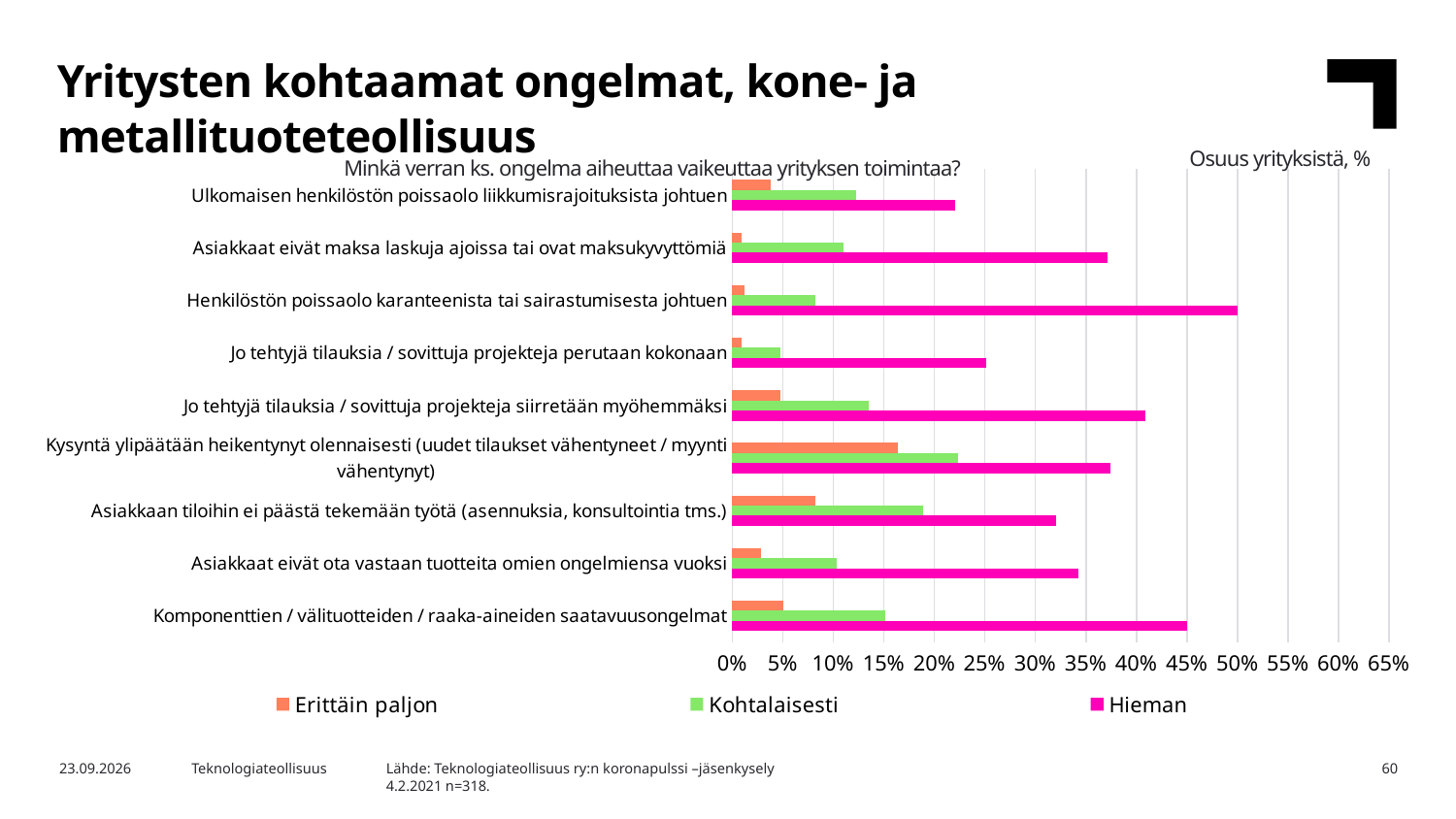
Which category has the highest value for the 'Erittäin paljon' series? Kysyntä ylipäätään heikentynyt olennaisesti (uudet tilaukset vähentyneet / myynti vähentynyt) Which category has the highest value for the 'Kohtalaisesti' series? Kysyntä ylipäätään heikentynyt olennaisesti (uudet tilaukset vähentyneet / myynti vähentynyt) For the 'Hieman' series, which is larger: 'Henkilöstön poissaolo karanteenista tai sairastumisesta johtuen' or 'Asiakkaat eivät maksa laskuja ajoissa tai ovat maksukyvyttömiä'? Henkilöstön poissaolo karanteenista tai sairastumisesta johtuen Which colour represents the 'Hieman' series in the legend? Magenta (pink) Which category has the highest value for the 'Hieman' series? Henkilöstön poissaolo karanteenista tai sairastumisesta johtuen How many series does the legend list? 3 Is the 'Hieman' value for 'Kysyntä ylipäätään heikentynyt olennaisesti' greater or less than 35%? greater How many problem categories are plotted on the chart? 9 Is the 'Hieman' value for 'Asiakkaat eivät ota vastaan tuotteita omien ongelmiensa vuoksi' greater or less than 30%? greater Is the 'Hieman' value for 'Ulkomaisen henkilöstön poissaolo liikkumisrajoituksista johtuen' greater or less than 25%? less What kind of chart is shown on the slide? Bar chart